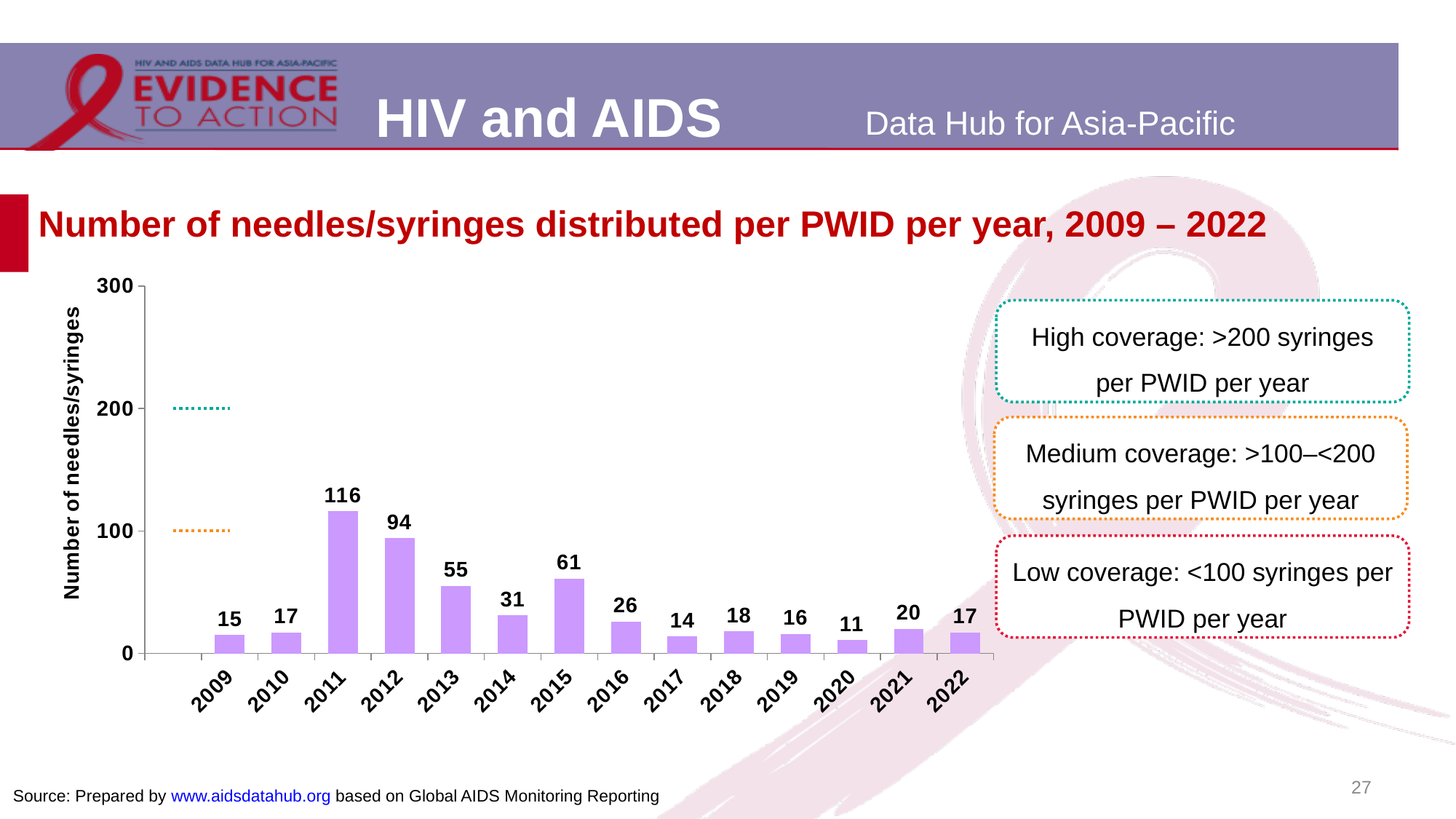
What is the title of the chart? Number of needles/syringes distributed per PWID per year, 2009 – 2022 How many years are shown on the x axis? 14 Which year has the highest number of needles/syringes distributed per PWID? 2011 What is the value shown for 2022? 17 What kind of chart is shown on the slide? Bar chart What is the difference between the values for 2011 and 2012? 22 What is the difference between the values for 2013 and 2014? 24 What is the value shown for 2015? 61 Is the value for 2011 greater or less than 100? greater Which year has a larger value, 2015 or 2016? 2015 Which year has the lowest number of needles/syringes distributed per PWID? 2020 What is the number of needles/syringes distributed per PWID in 2011? 116